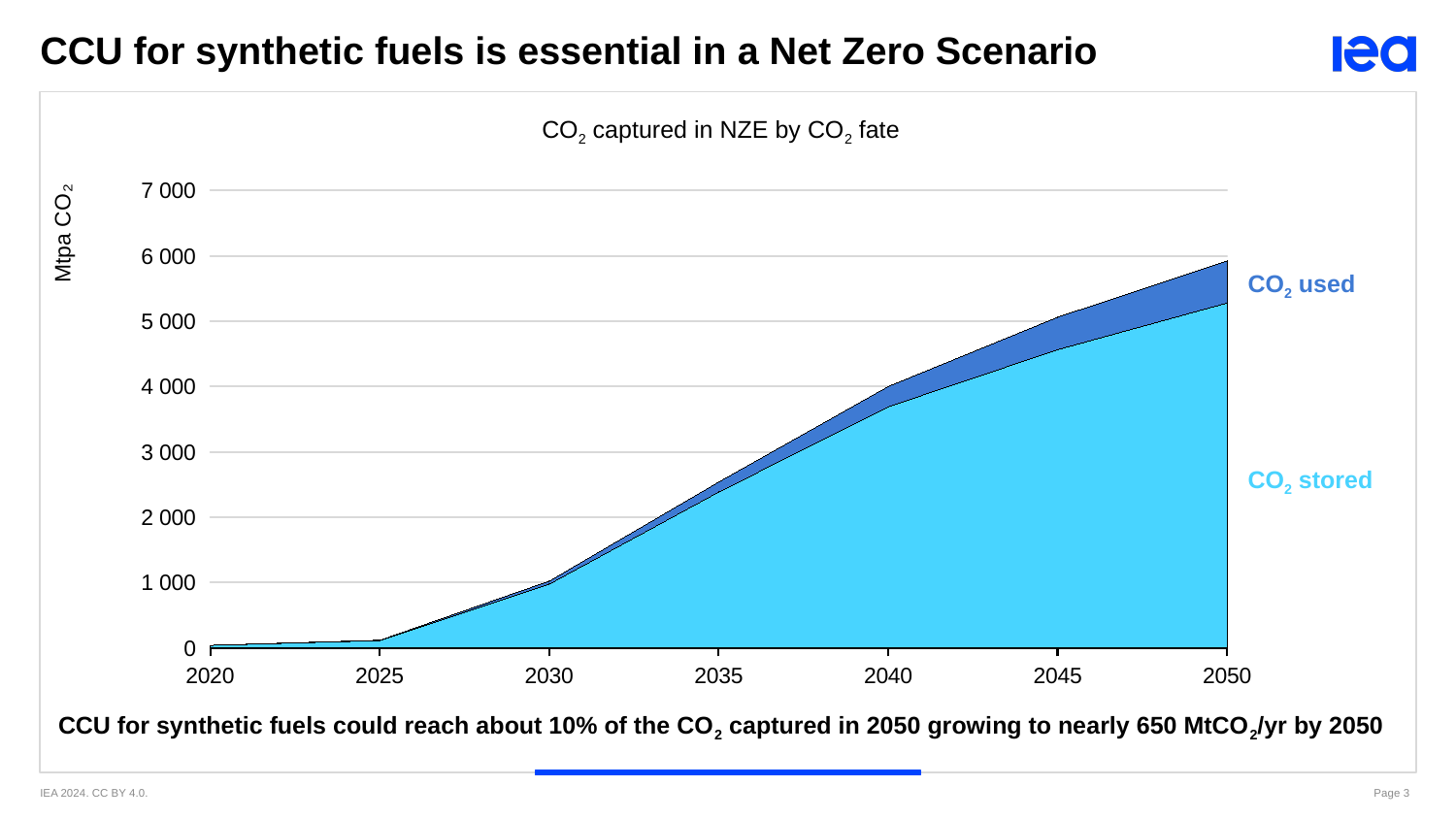
What kind of chart is shown on the slide? Area chart Is the total CO2 captured in 2030 greater or less than 2 000? less How many year labels are shown on the x axis? 7 How many series does the chart show? 2 Is the value for CO2 stored in 2050 greater or less than 4 000? greater Is the total CO2 captured in 2050 greater or less than 5 000? greater Does the total CO2 captured rise or fall from 2020 to 2050? Rise What is the title of the chart? CO2 captured in NZE by CO2 fate What unit is shown on the y axis of the chart? Mtpa CO2 In 2050, which is larger: CO2 stored or CO2 used? CO2 stored